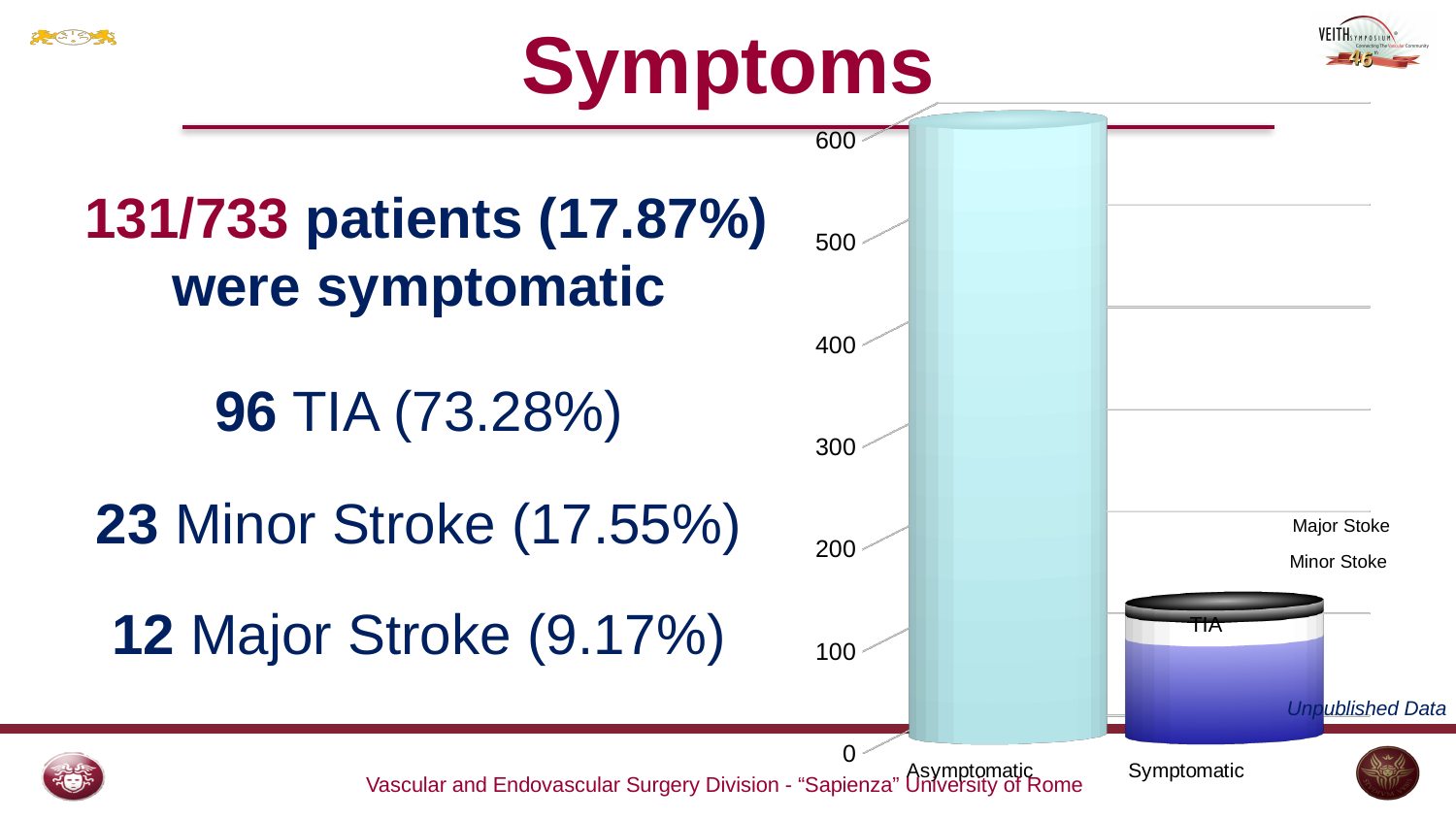
Which category has the tallest bar in the chart? Asymptomatic According to the slide, how many patients were symptomatic? 131 Is the total value for Symptomatic greater or less than 200? less Which bar is larger, Asymptomatic or Symptomatic? Asymptomatic What is the highest tick value shown on the vertical axis of the chart? 600 Which segment makes up the largest part of the Symptomatic bar? TIA How many categories are shown on the x axis of the chart? 2 What are the two category labels on the x axis of the chart? Asymptomatic, Symptomatic Is the total value for Symptomatic greater or less than 100? greater What kind of chart is shown on the slide? bar chart Which category has the shortest bar in the chart? Symptomatic